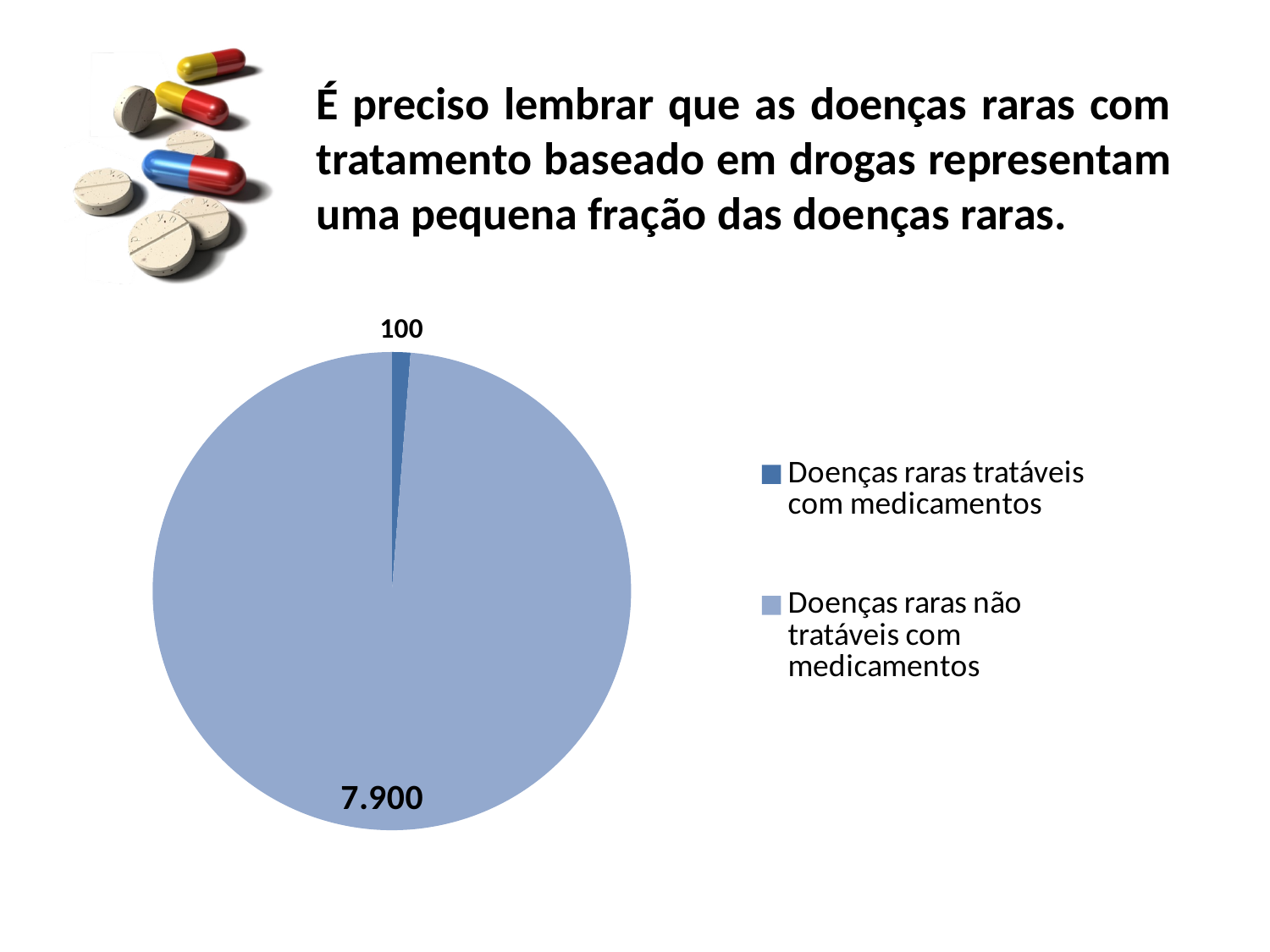
What value is shown for the slice "Doenças raras tratáveis com medicamentos"? 100 What is the total of the two values shown in the pie chart? 8.000 How many entries does the legend list? 2 How many slices does the pie chart have? 2 Which category has the smallest slice of the pie? Doenças raras tratáveis com medicamentos What is the difference between the value for "Doenças raras não tratáveis com medicamentos" and the value for "Doenças raras tratáveis com medicamentos"? 7.800 Which colour is used for the slice "Doenças raras tratáveis com medicamentos"? Dark blue What share of the pie does "Doenças raras tratáveis com medicamentos" represent? 1.25% What kind of chart is shown on the slide? Pie chart What value is shown for the slice "Doenças raras não tratáveis com medicamentos"? 7.900 Which is larger: the value for "Doenças raras tratáveis com medicamentos" or the value for "Doenças raras não tratáveis com medicamentos"? Doenças raras não tratáveis com medicamentos Which category has the largest slice of the pie? Doenças raras não tratáveis com medicamentos